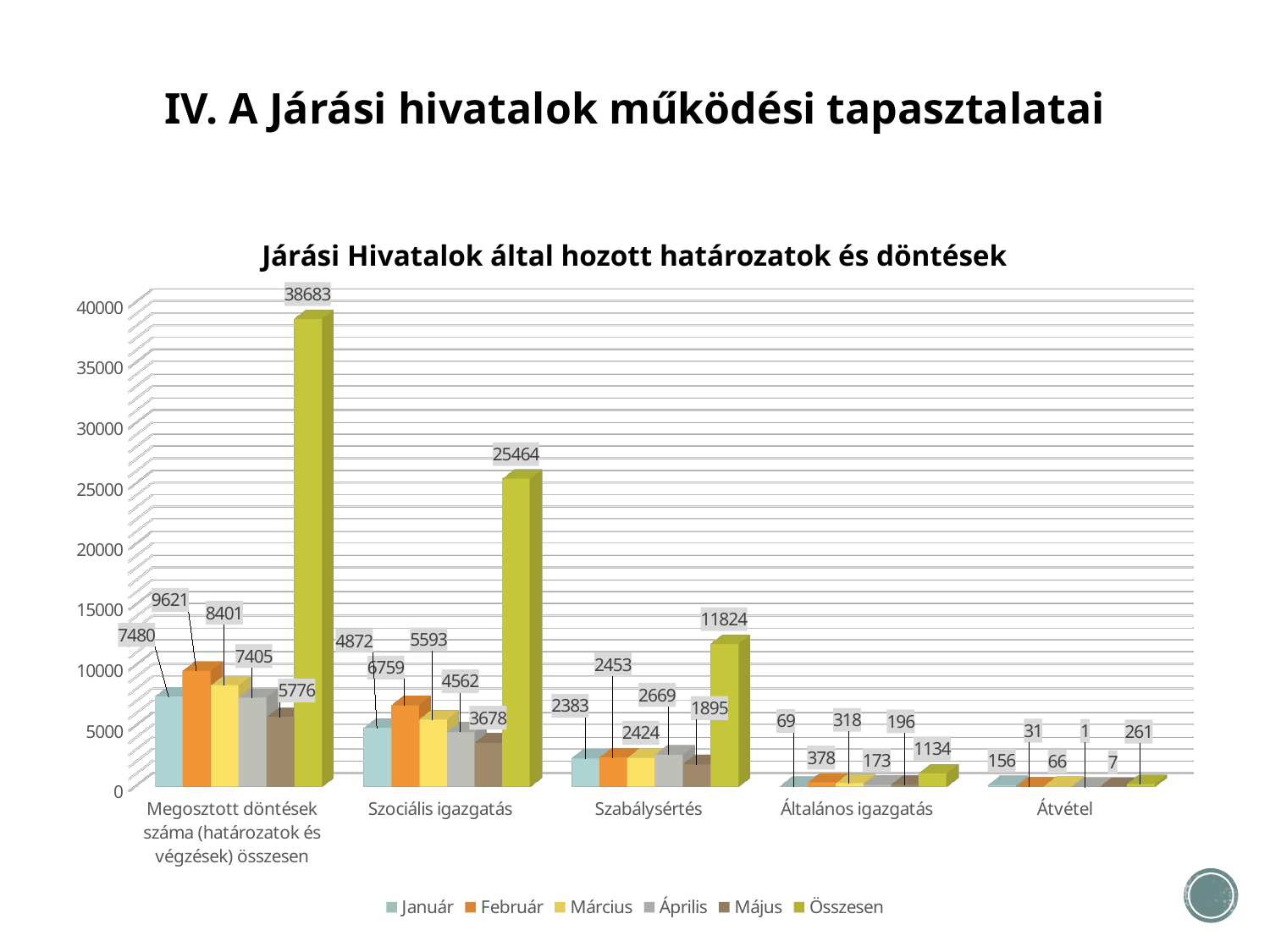
What is the Április value for Átvétel? 1 What is the Összesen value for Szociális igazgatás? 25464 How many categories are shown on the x axis? 5 Which category has the highest Összesen value? Megosztott döntések száma (határozatok és végzések) összesen What is the Május value for Szabálysértés? 1895 What kind of chart is shown on the slide? Bar chart Which category has the lowest Összesen value? Átvétel Which is larger for Általános igazgatás: the Február value or the Március value? Február What is the difference between the Február and Május values for Szociális igazgatás? 3081 What is the Február value for Megosztott döntések száma (határozatok és végzések) összesen? 9621 Is the Összesen value for Szabálysértés greater or less than 10000? greater How many series does the legend list? 6